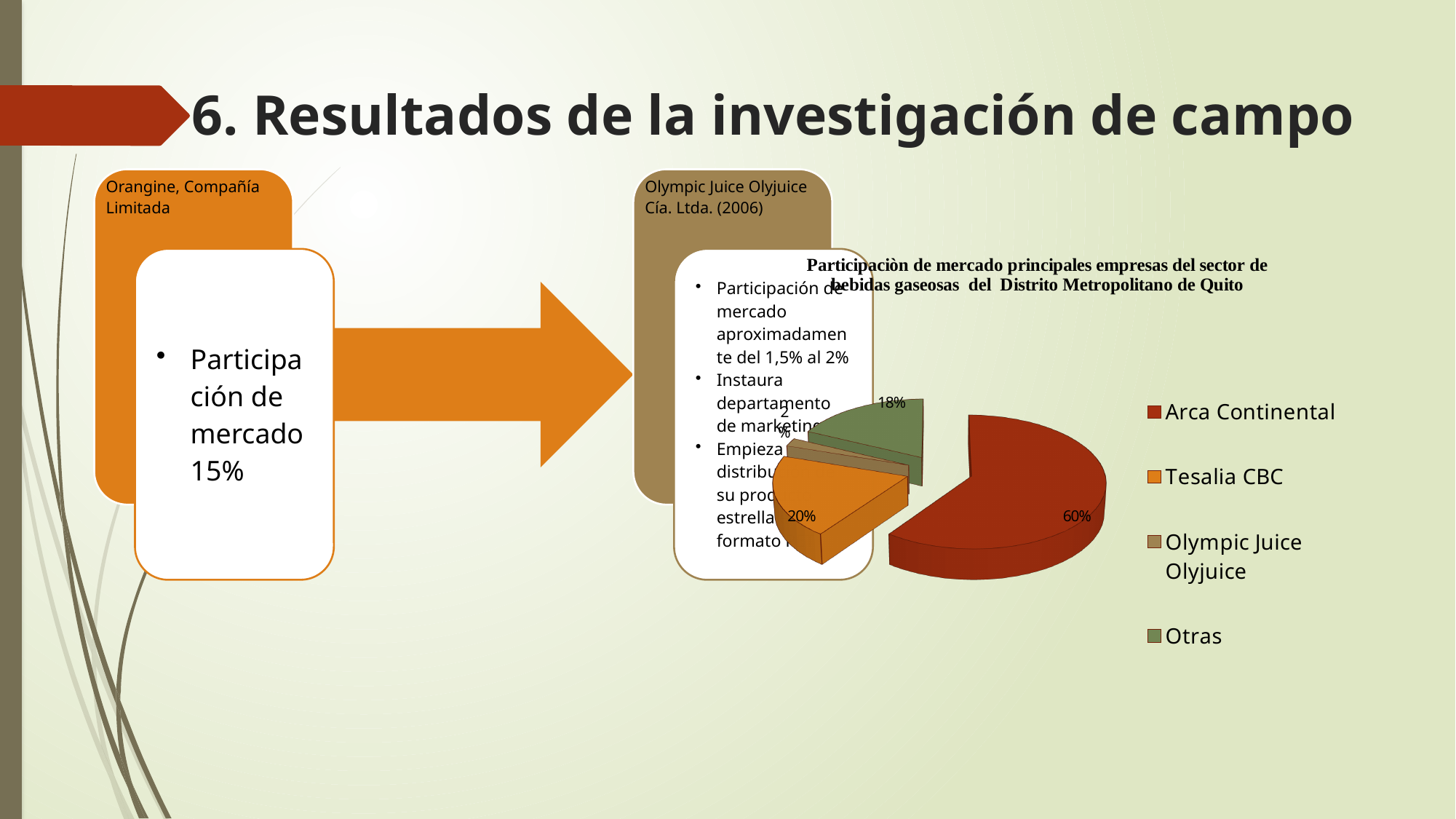
What is the difference between the shares of Arca Continental and Tesalia CBC in the pie chart? 40% How many categories does the legend of the pie chart list? 4 Which has a larger share in the pie chart, Tesalia CBC or Otras? Tesalia CBC What is the market share shown for Tesalia CBC in the pie chart? 20% What colour is the slice for Arca Continental in the pie chart? red Which category has the smallest slice in the pie chart? Olympic Juice Olyjuice What is the market share shown for Arca Continental in the pie chart? 60% What type of chart is shown on the slide? pie chart What is the difference between the shares of Otras and Olympic Juice Olyjuice in the pie chart? 16% What is the market share shown for Otras in the pie chart? 18% What is the market share shown for Olympic Juice Olyjuice in the pie chart? 2% Which company has the largest slice in the pie chart? Arca Continental